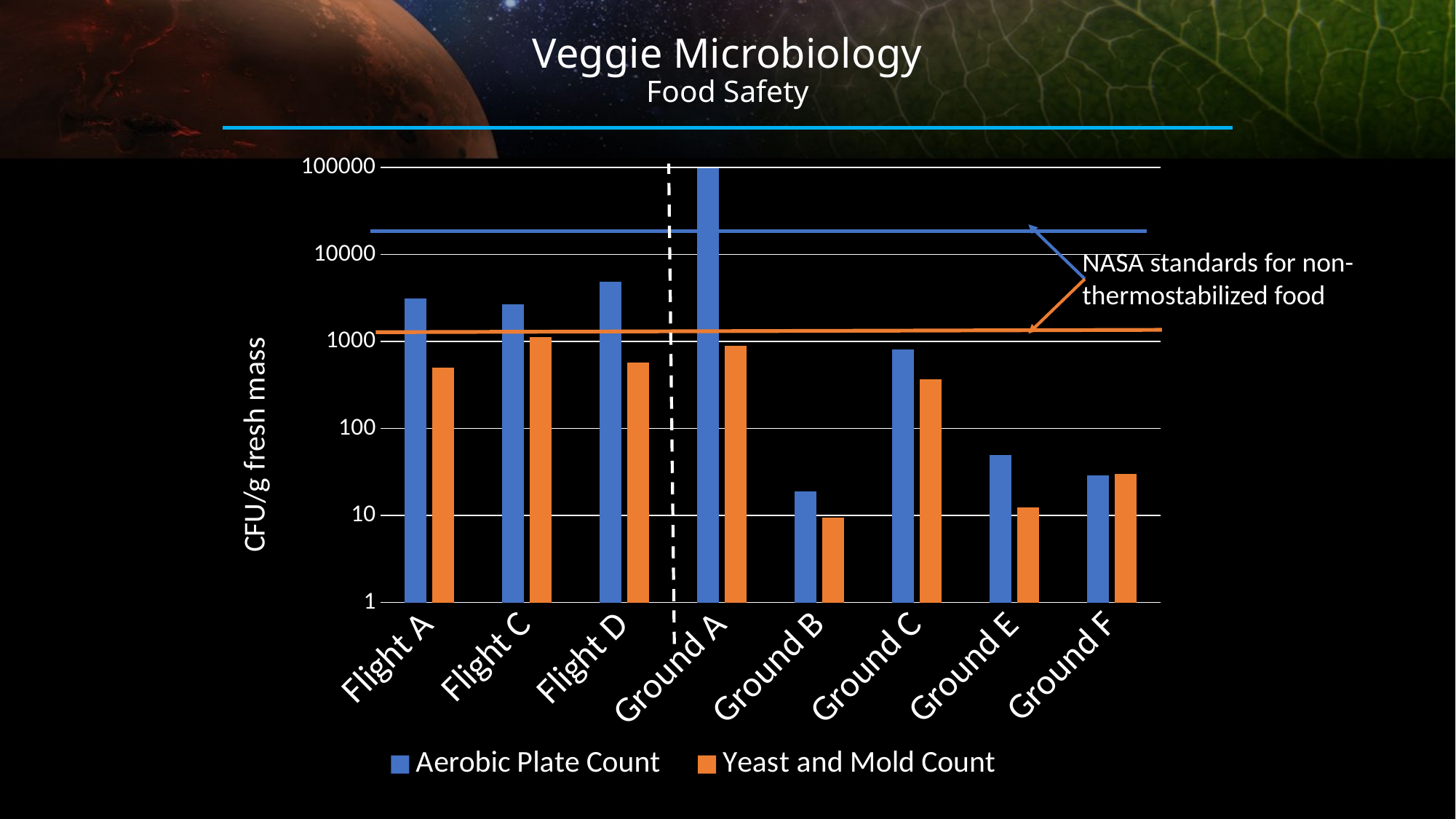
How many series does the chart's legend list? 2 Is the Yeast and Mold Count for Flight A greater or less than 1000? less Is the Aerobic Plate Count for Ground A greater or less than 10000? greater Which category has the lowest Yeast and Mold Count? Ground B What is the label on the chart's y axis? CFU/g fresh mass Which is larger for Flight A, the Aerobic Plate Count or the Yeast and Mold Count? Aerobic Plate Count Which has the larger Yeast and Mold Count, Flight C or Flight D? Flight C Which category has the highest Aerobic Plate Count? Ground A Is the Aerobic Plate Count for Flight A greater or less than 1000? greater How many categories are shown along the x axis of the chart? 8 What kind of chart is shown on the slide? bar chart